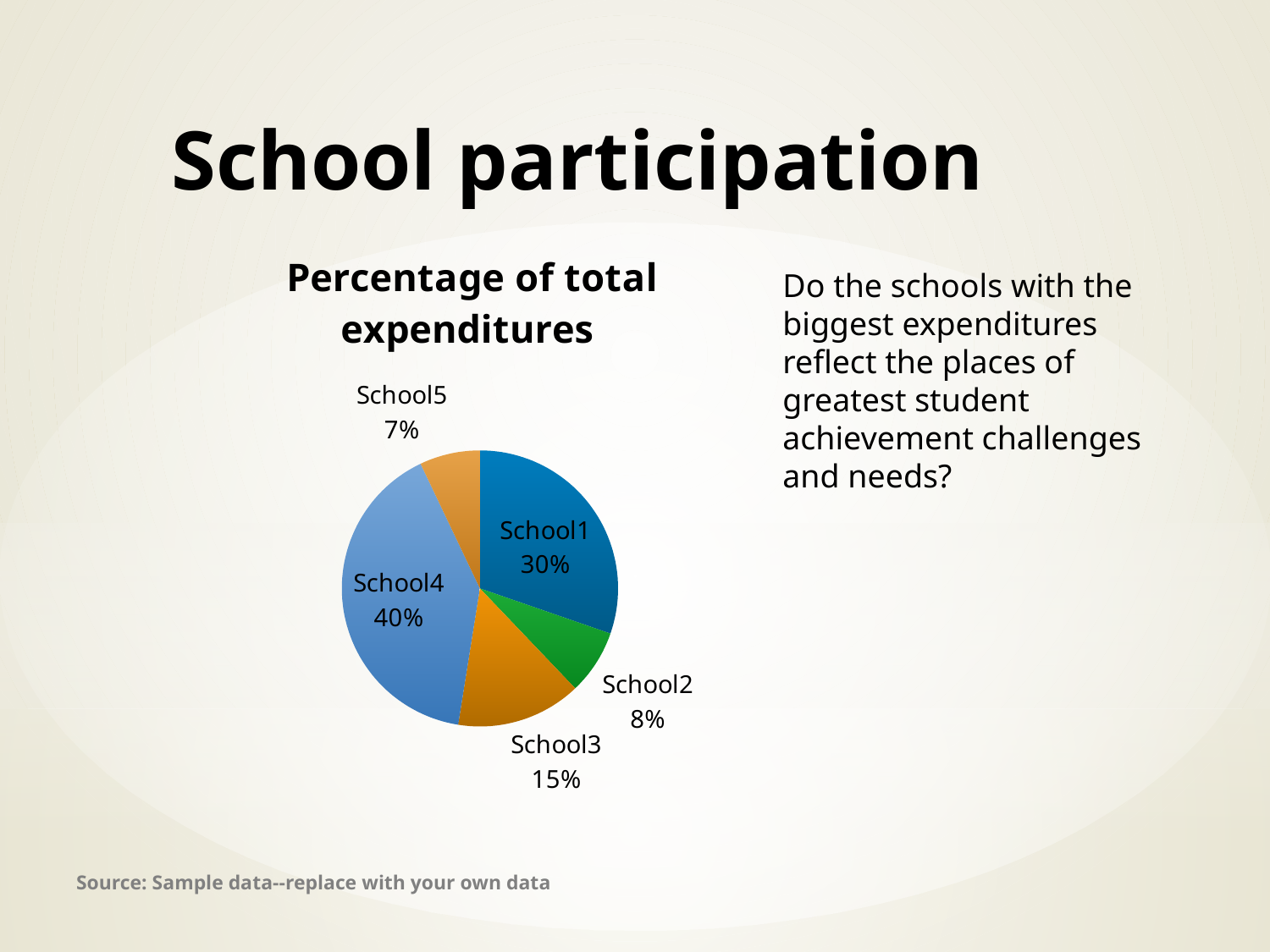
What is the title of the chart? Percentage of total expenditures What percentage of total expenditures does School3 account for? 15% What percentage of total expenditures does School1 account for? 30% What percentage of total expenditures does School4 account for? 40% What type of chart is shown on the slide? pie chart What is the difference in percentage points between School4 and School1? 10 What is the combined share of School1 and School4? 70% Which has a larger share of total expenditures, School2 or School3? School3 How many schools are shown in the pie chart? 5 What percentage of total expenditures does School5 account for? 7% Which school has the smallest share of total expenditures? School5 Which school has the largest share of total expenditures? School4